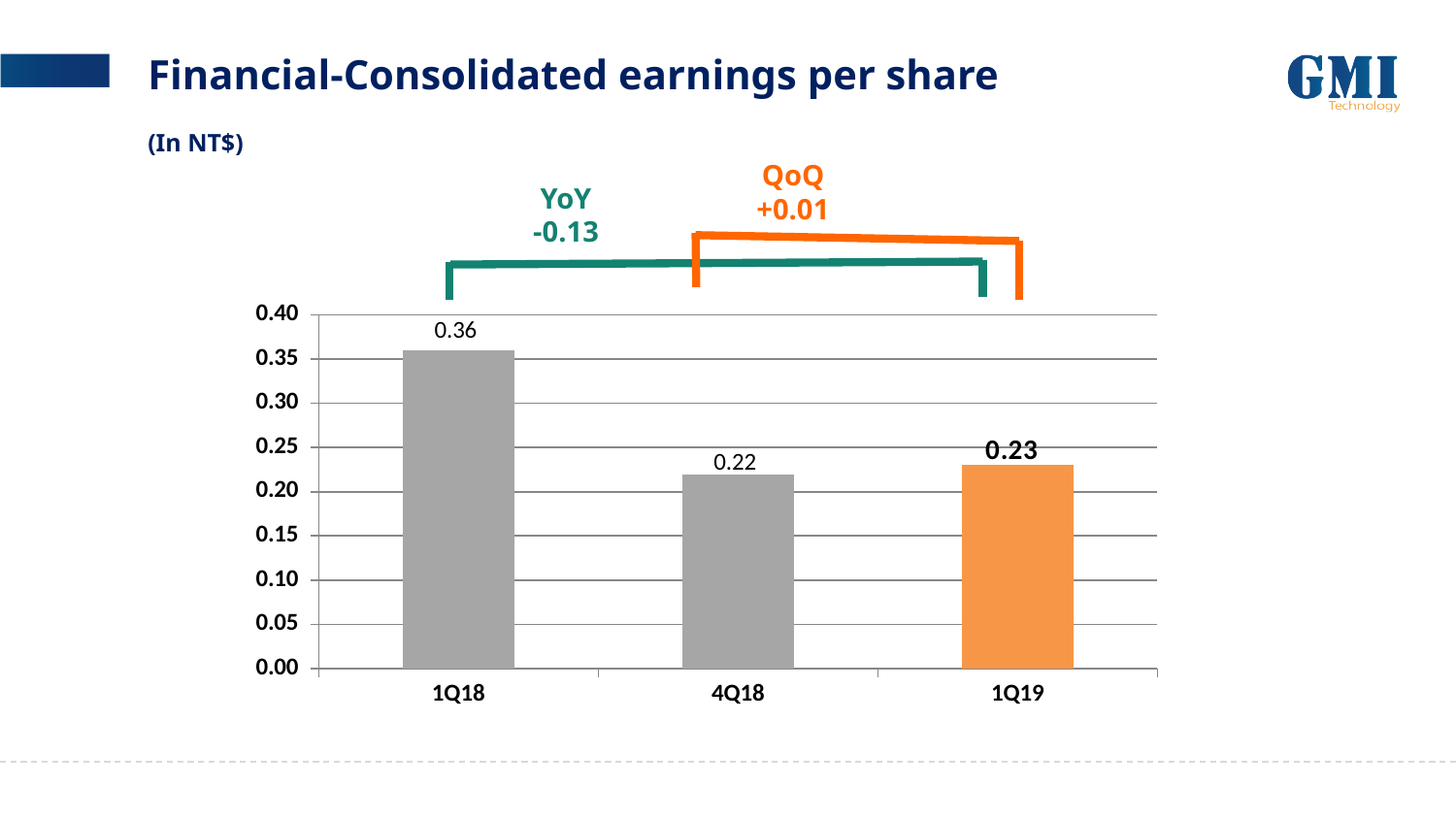
What is the difference in earnings per share between 1Q19 and 4Q18? 0.01 What is the difference in earnings per share between 1Q18 and 1Q19? 0.13 Which quarter has the highest earnings per share? 1Q18 What is the consolidated earnings per share for 1Q19? 0.23 Which quarter has the lowest earnings per share? 4Q18 What is the consolidated earnings per share for 1Q18? 0.36 What is the consolidated earnings per share for 4Q18? 0.22 Is the earnings per share for 1Q18 greater or less than 0.30? greater How many quarters are shown in the chart? 3 What YoY change is annotated on the chart? -0.13 In what currency are the values on the chart expressed? NT$ What kind of chart is shown on the slide? Bar chart